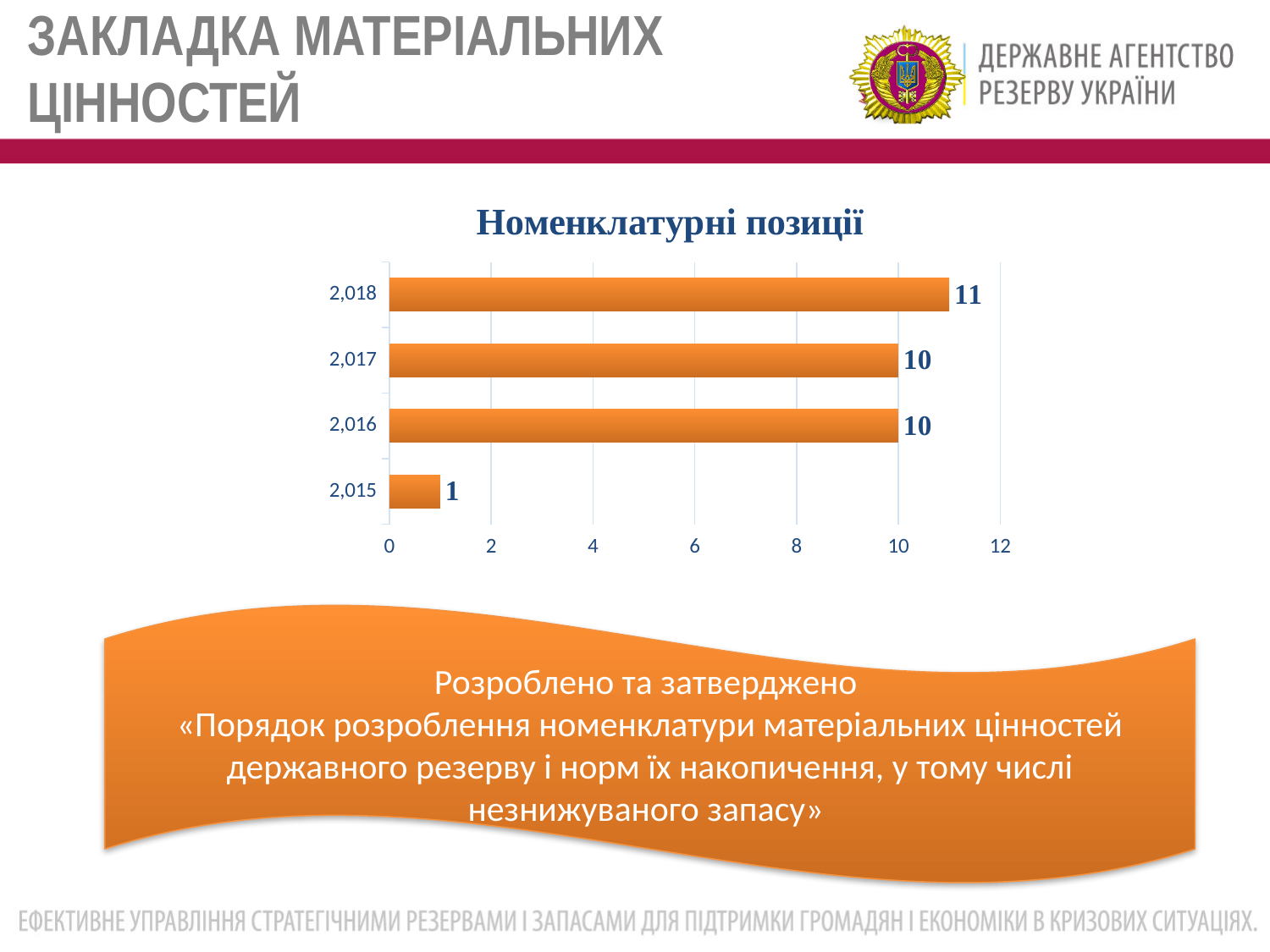
Which year has the highest value in the chart 'Номенклатурні позиції'? 2,018 What is the value for 2,016 in the chart 'Номенклатурні позиції'? 10 Which is larger in the chart 'Номенклатурні позиції': the value for 2,016 or the value for 2,015? 2,016 How many years are shown in the chart 'Номенклатурні позиції'? 4 Which year has the lowest value in the chart 'Номенклатурні позиції'? 2,015 What is the value for 2,015 in the chart 'Номенклатурні позиції'? 1 What is the difference between the values for 2,018 and 2,015 in the chart 'Номенклатурні позиції'? 10 What kind of chart is 'Номенклатурні позиції'? Bar chart What is the title of the chart on the slide? Номенклатурні позиції Is the value for 2,018 in the chart 'Номенклатурні позиції' greater or less than 10? greater What is the value for 2,018 in the chart 'Номенклатурні позиції'? 11 What is the difference between the values for 2,018 and 2,017 in the chart 'Номенклатурні позиції'? 1